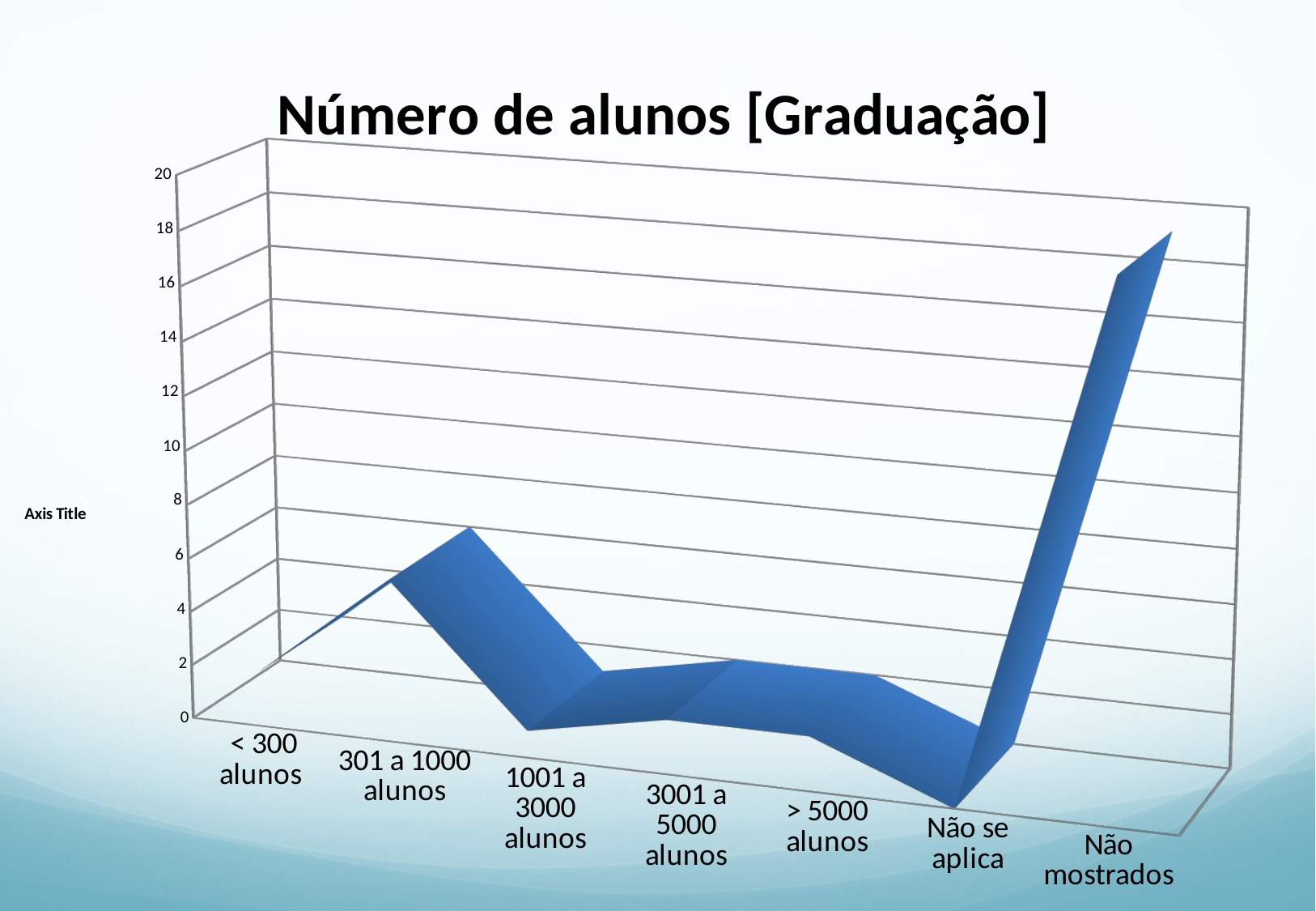
What is the label shown on the vertical axis of the chart? Axis Title Which is larger, the value for Não se aplica or the value for Não mostrados? Não mostrados Is the value for Não mostrados greater or less than 10? greater Which is larger, the value for < 300 alunos or the value for 301 a 1000 alunos? 301 a 1000 alunos What is the maximum value shown on the vertical axis of the chart? 20 How many categories are shown on the x axis of the chart? 7 What is the title of the chart? Número de alunos [Graduação] What kind of chart is shown on the slide? line chart Is the value for 1001 a 3000 alunos greater or less than 4? less Is the value for 301 a 1000 alunos greater or less than 10? less Does the value rise or fall from Não se aplica to Não mostrados? rise Which category has the highest value in the chart? Não mostrados